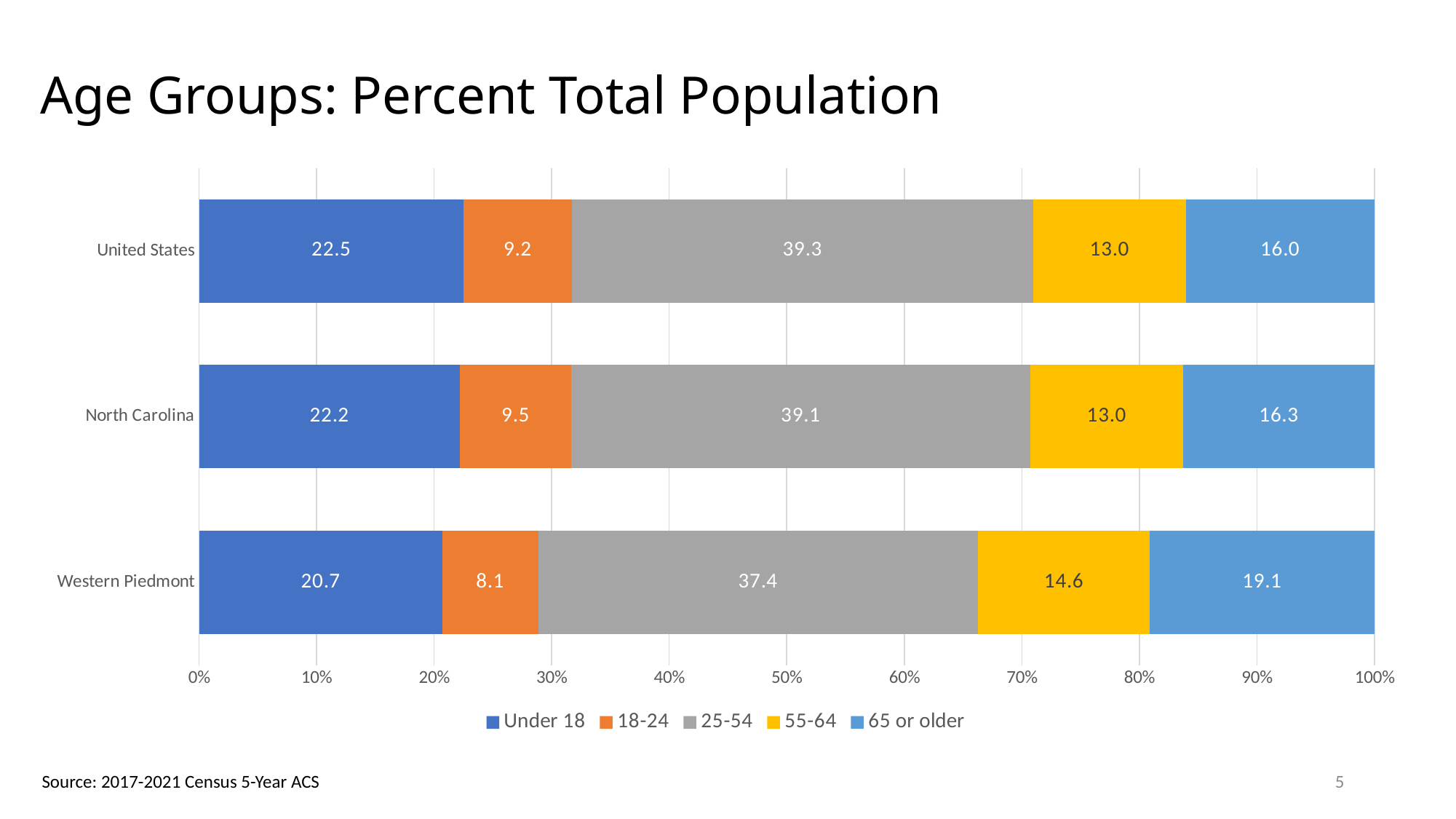
Which region has the lowest value for the Under 18 age group? Western Piedmont What is the title of the chart? Age Groups: Percent Total Population What is the value for the 25-54 age group in the United States? 39.3 What is the value for the 18-24 age group in North Carolina? 9.5 Which is larger, the 18-24 value for the United States or for Western Piedmont? United States Which region has the highest value for the 65 or older age group? Western Piedmont What is the value for the 65 or older age group in Western Piedmont? 19.1 How many regions are shown on the chart? 3 How many series does the legend list? 5 What is the difference between the 55-64 values for Western Piedmont and North Carolina? 1.6 What kind of chart is shown on the slide? Stacked bar chart What is the total of the Under 18 and 18-24 values for Western Piedmont? 28.8